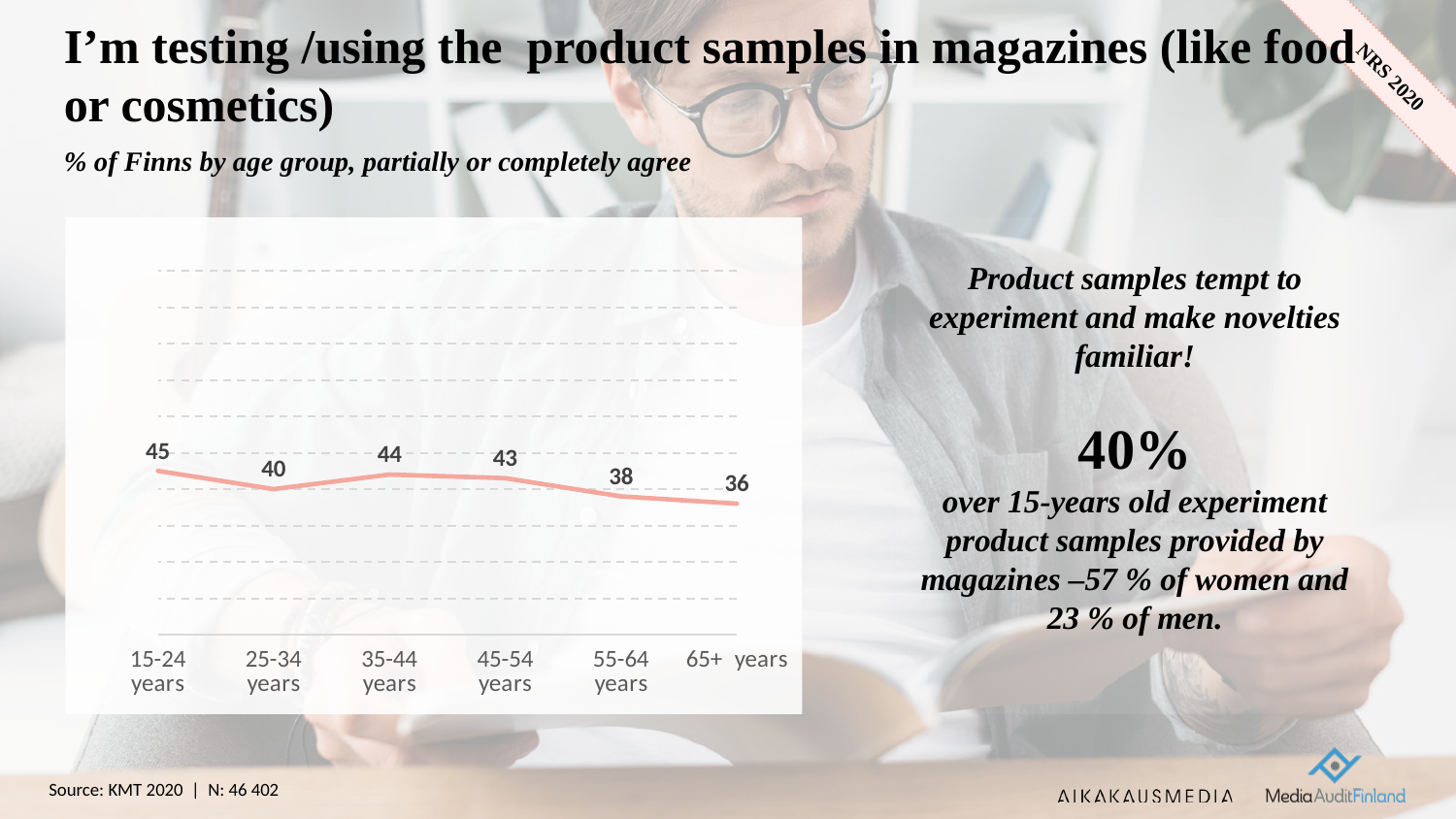
What is the value for the 35-44 years age group? 44 What colour is the line in the chart? red What is the value for the 65+ years age group? 36 What is the difference between the values for 15-24 years and 65+ years? 9 What kind of chart is shown on the slide? line chart How many age groups are plotted on the chart? 6 Which is larger, the value for 25-34 years or the value for 45-54 years? 45-54 years What is the difference between the values for 35-44 years and 25-34 years? 4 What is the value for the 15-24 years age group? 45 Which age group has the lowest value? 65+ years Do the values generally rise or fall from the youngest to the oldest age group? fall Which age group has the highest value? 15-24 years